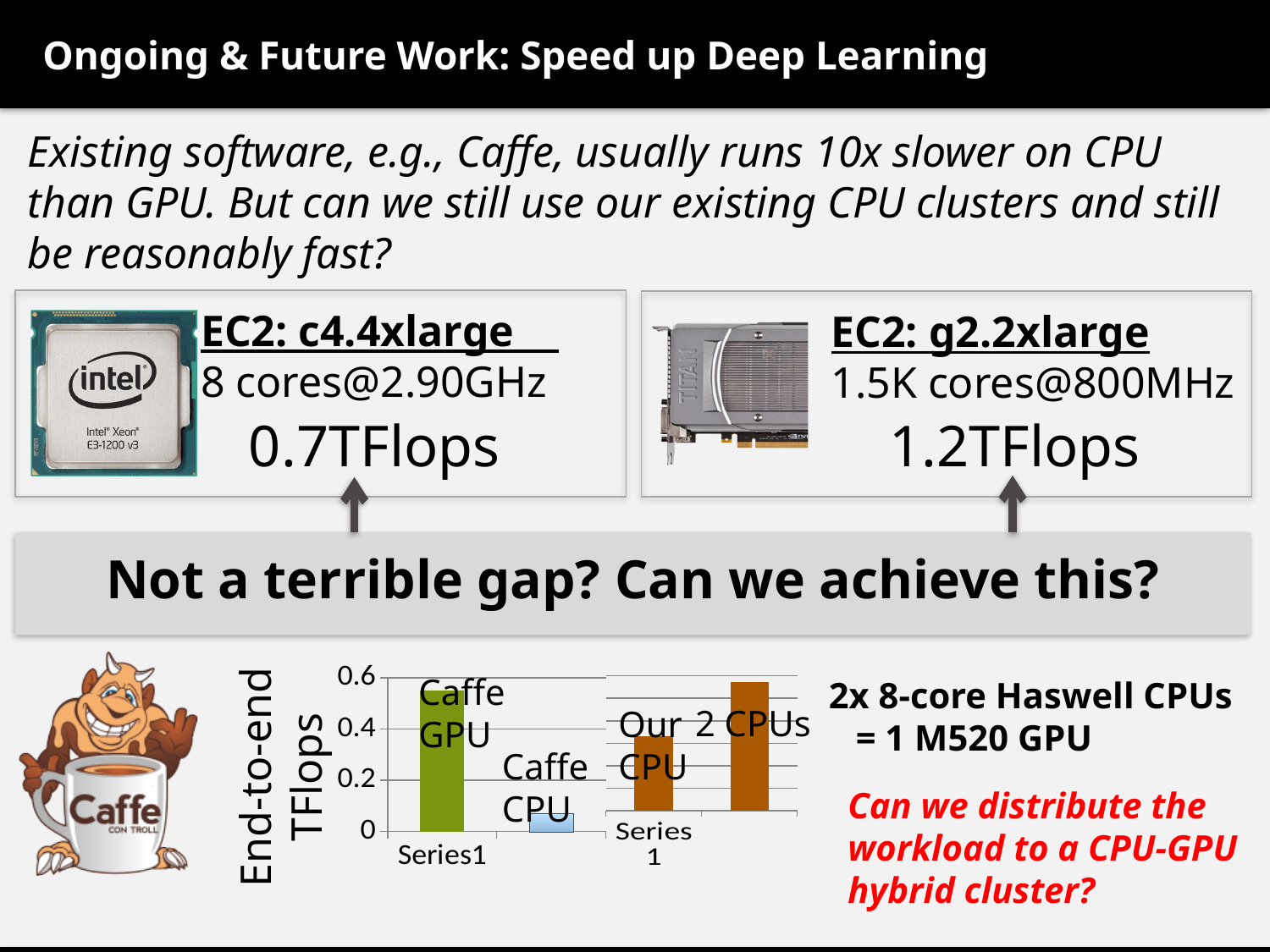
In the right bottom chart (Our CPU and Our 2 CPUs), which bar is higher, Our CPU or Our 2 CPUs? Our 2 CPUs What is the y-axis label shared by the bottom charts? End-to-end TFlops In the right bottom chart, is the value for Our CPU greater or less than 0.2? greater In the left bottom chart, is the value for Caffe CPU greater or less than 0.2? less In the left bottom chart, which bar is lowest? Caffe CPU In the left bottom chart, what colour is the Caffe GPU bar? green What kind of chart is the left chart at the bottom of the slide (with Caffe GPU and Caffe CPU)? bar chart How many bars are plotted in the right bottom chart? 2 How many bars are plotted in the left bottom chart? 2 In the right bottom chart, is the value for Our 2 CPUs greater or less than 0.4? greater In the left bottom chart, which bar is highest, Caffe GPU or Caffe CPU? Caffe GPU